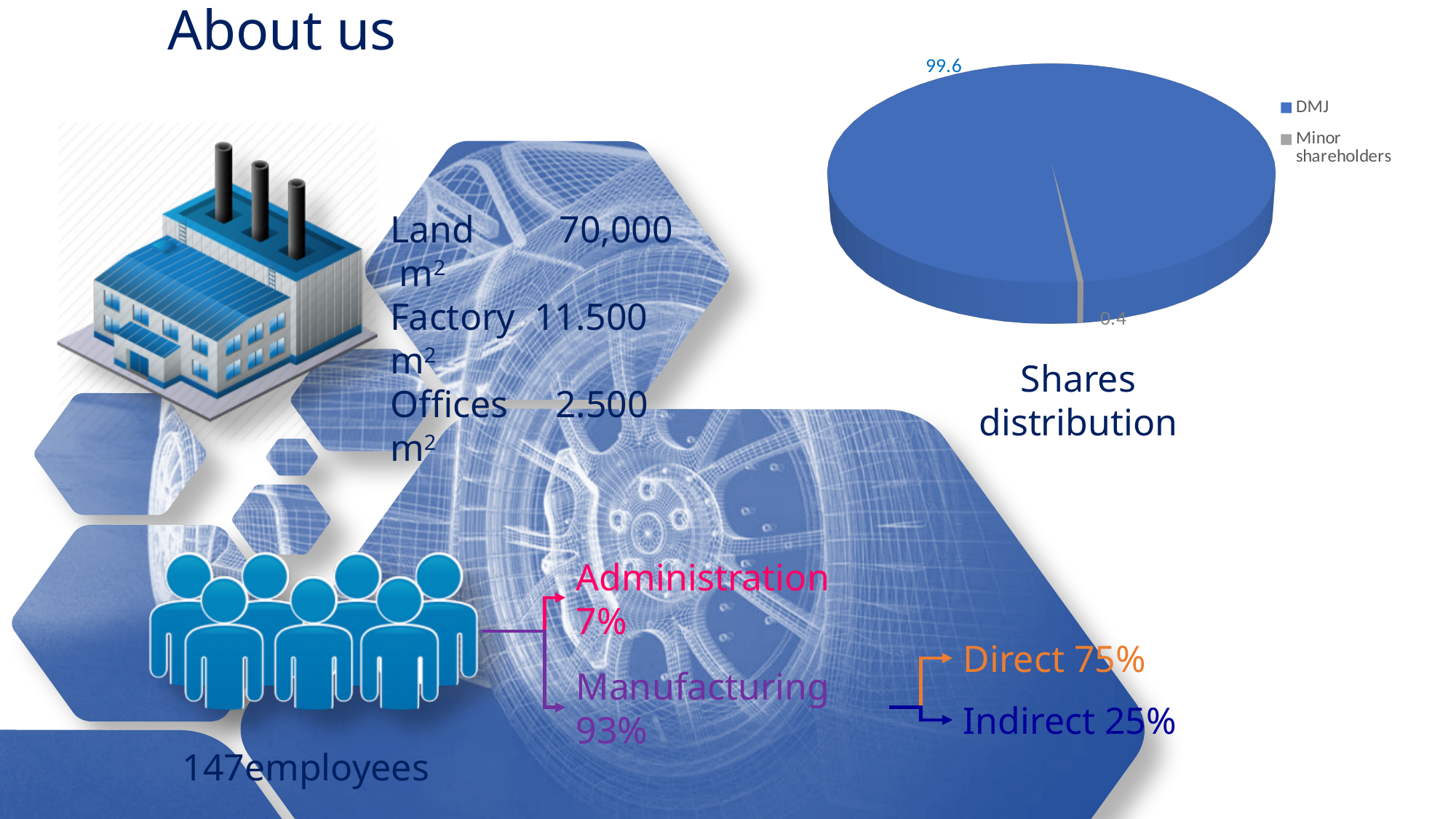
How many slices does the Shares distribution pie chart have? 2 Which category has the largest slice in the Shares distribution pie chart? DMJ In the Shares distribution pie chart, what is the difference between the DMJ value and the Minor shareholders value? 99.2 What is the title of the pie chart on the slide? Shares distribution Which category has the smallest slice in the Shares distribution pie chart? Minor shareholders What kind of chart is shown under the title "Shares distribution"? pie chart In the Shares distribution pie chart, what colour is the DMJ slice? blue How many entries does the legend of the Shares distribution pie chart list? 2 In the Shares distribution pie chart, which is larger: DMJ or Minor shareholders? DMJ In the Shares distribution pie chart, what is the value for Minor shareholders? 0.4 In the Shares distribution pie chart, what is the value for DMJ? 99.6